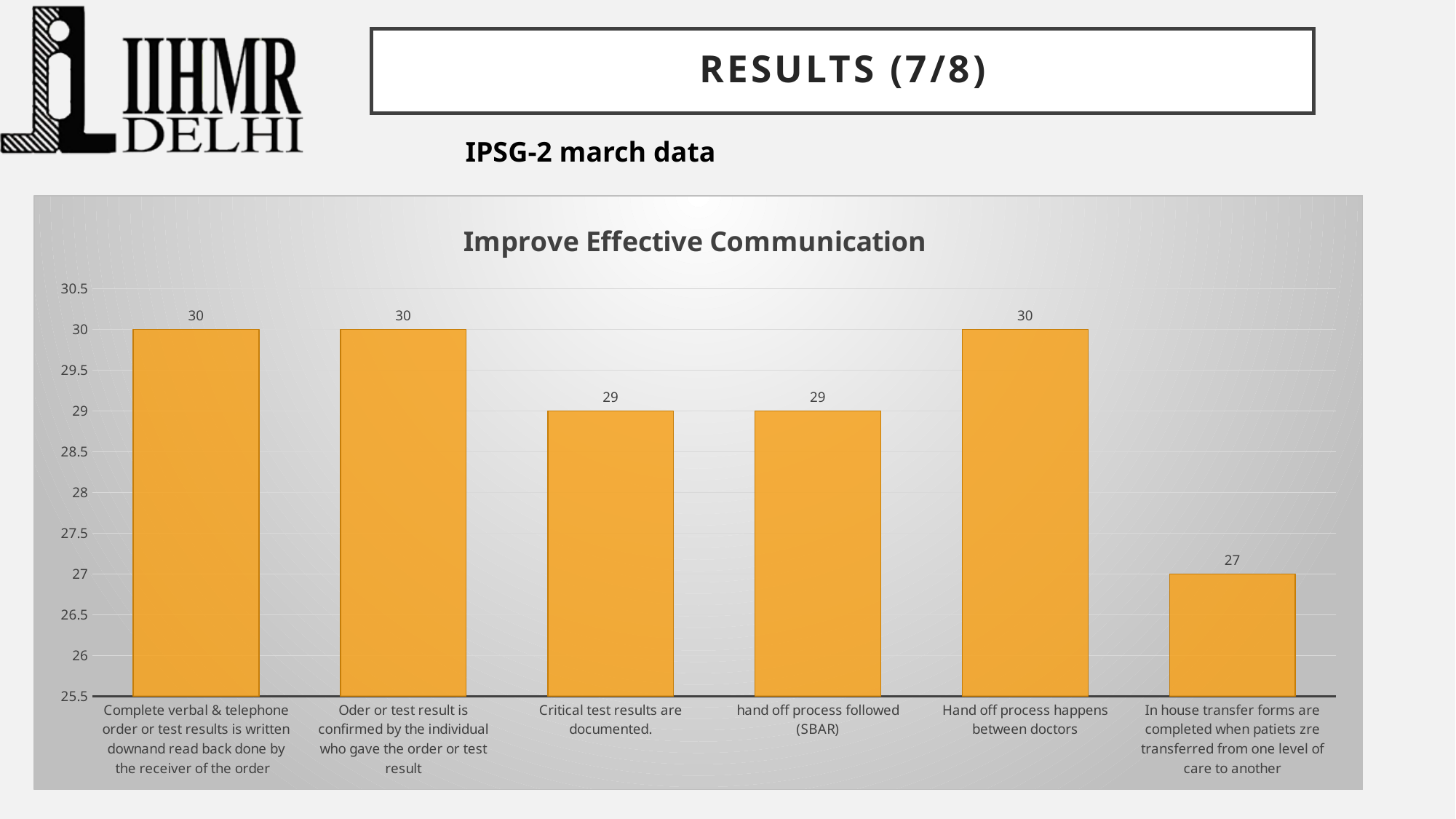
What kind of chart is shown on the slide? Bar chart Which is larger: the value for "Complete verbal & telephone order or test results is written downand read back done by the receiver of the order" or the value for "hand off process followed (SBAR)"? Complete verbal & telephone order or test results is written downand read back done by the receiver of the order What is the value for "hand off process followed (SBAR)"? 29 What is the title of the chart? Improve Effective Communication How many categories are shown in the chart? 6 What is the difference between the value for "Oder or test result is confirmed by the individual who gave the order or test result" and the value for "Critical test results are documented."? 1 What is the value for "In house transfer forms are completed when patiets zre transferred from one level of care to another"? 27 Which category has the lowest value? In house transfer forms are completed when patiets zre transferred from one level of care to another What is the value for "Critical test results are documented."? 29 How many categories have a value of 30? 3 What is the value for "Hand off process happens between doctors"? 30 What is the difference between the value for "Hand off process happens between doctors" and the value for "In house transfer forms are completed when patiets zre transferred from one level of care to another"? 3